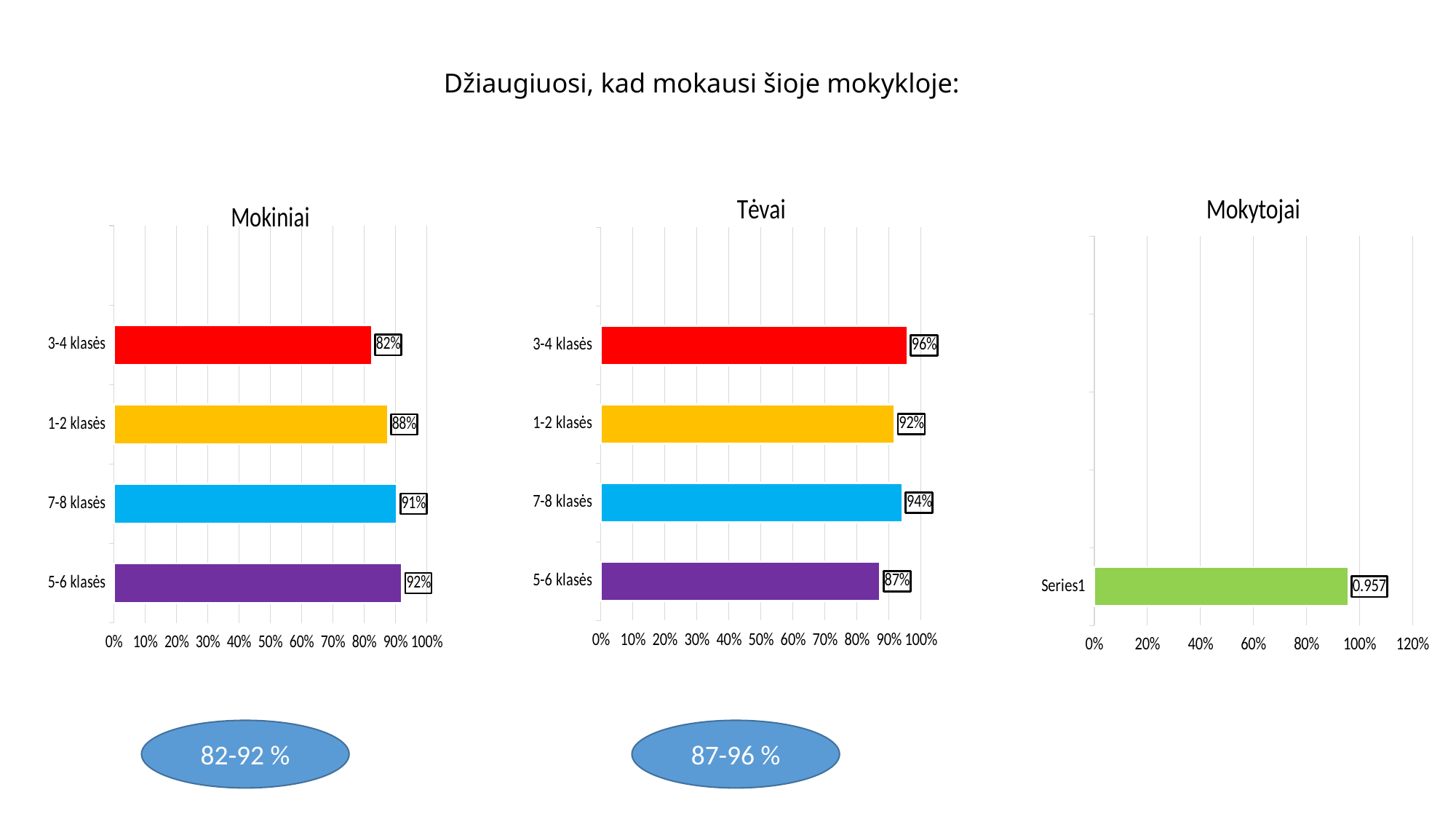
In the Tėvai chart, what is the value for 1-2 klasės? 92% In the Tėvai chart, which category has the lowest value? 5-6 klasės In the Mokiniai chart, what is the value for 3-4 klasės? 82% What kind of chart is the Mokytojai chart? bar chart In the Tėvai chart, what is the difference between the values for 3-4 klasės and 5-6 klasės? 9% In the Mokiniai chart, which is larger, the value for 1-2 klasės or the value for 3-4 klasės? 1-2 klasės How many categories does the Tėvai chart show? 4 What is the title of the chart on the left of the slide? Mokiniai In the Mokiniai chart, which category has the highest value? 5-6 klasės In the Mokytojai chart, what is the value for Series1? 0.957 In the Mokiniai chart, what is the value for 7-8 klasės? 91% In the Tėvai chart, what is the value for 5-6 klasės? 87%